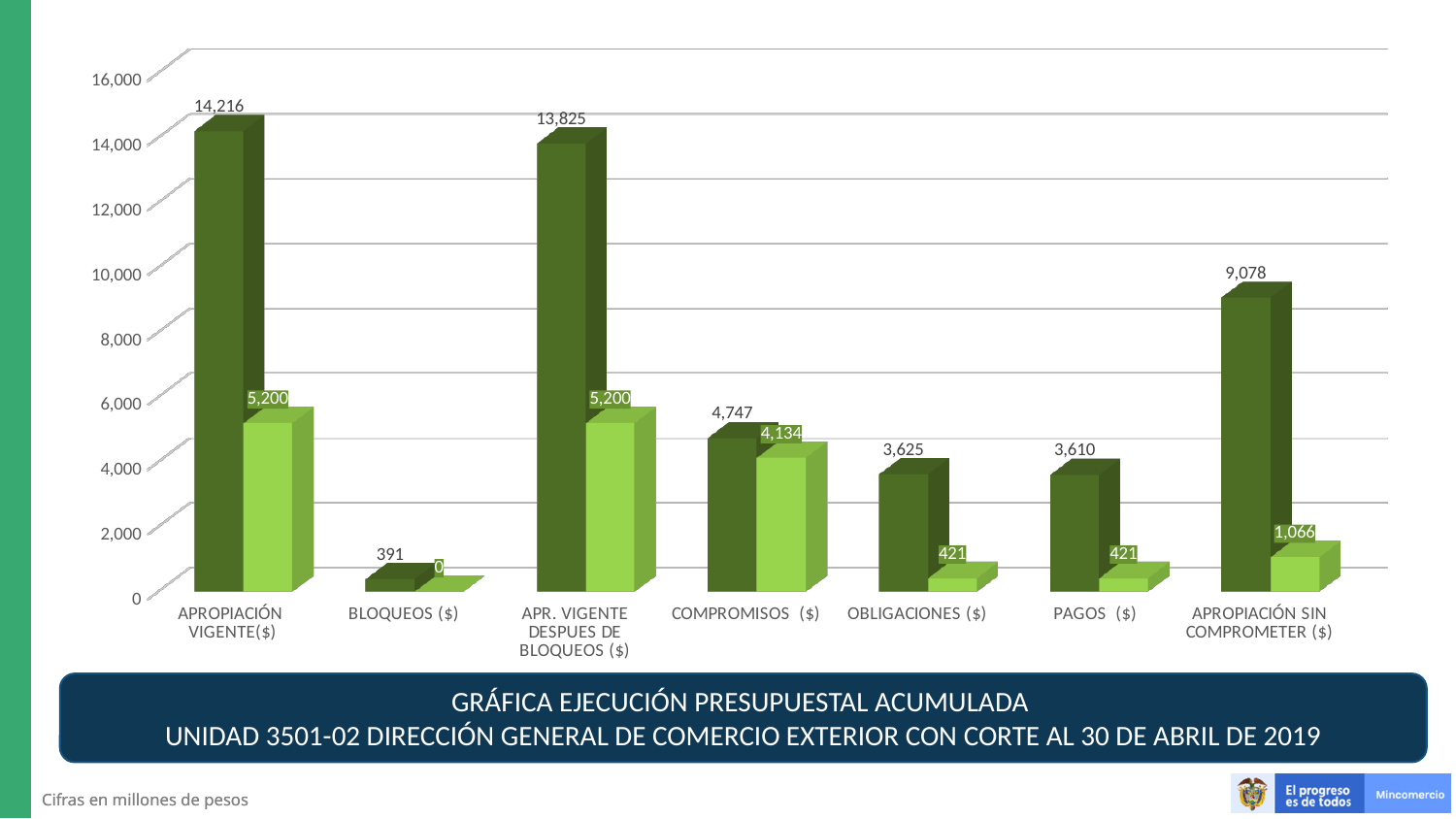
What is the light green bar value for APROPIACIÓN SIN COMPROMETER ($)? 1,066 What is the dark green bar value for BLOQUEOS ($)? 391 Which category has the lowest light green bar? BLOQUEOS ($) Which category has the highest dark green bar? APROPIACIÓN VIGENTE($) What is the light green bar value for COMPROMISOS ($)? 4,134 What is the difference between the dark green bars for APROPIACIÓN VIGENTE($) and APR. VIGENTE DESPUES DE BLOQUEOS ($)? 391 How many categories are shown on the x axis? 7 Is the dark green bar for OBLIGACIONES ($) greater or less than 4,000? less What unit are the figures in, according to the note at the bottom of the slide? millones de pesos What is the dark green bar value for APROPIACIÓN VIGENTE($)? 14,216 Which is larger: the dark green bar for COMPROMISOS ($) or the dark green bar for APROPIACIÓN SIN COMPROMETER ($)? APROPIACIÓN SIN COMPROMETER ($) What kind of chart is shown on the slide? bar chart